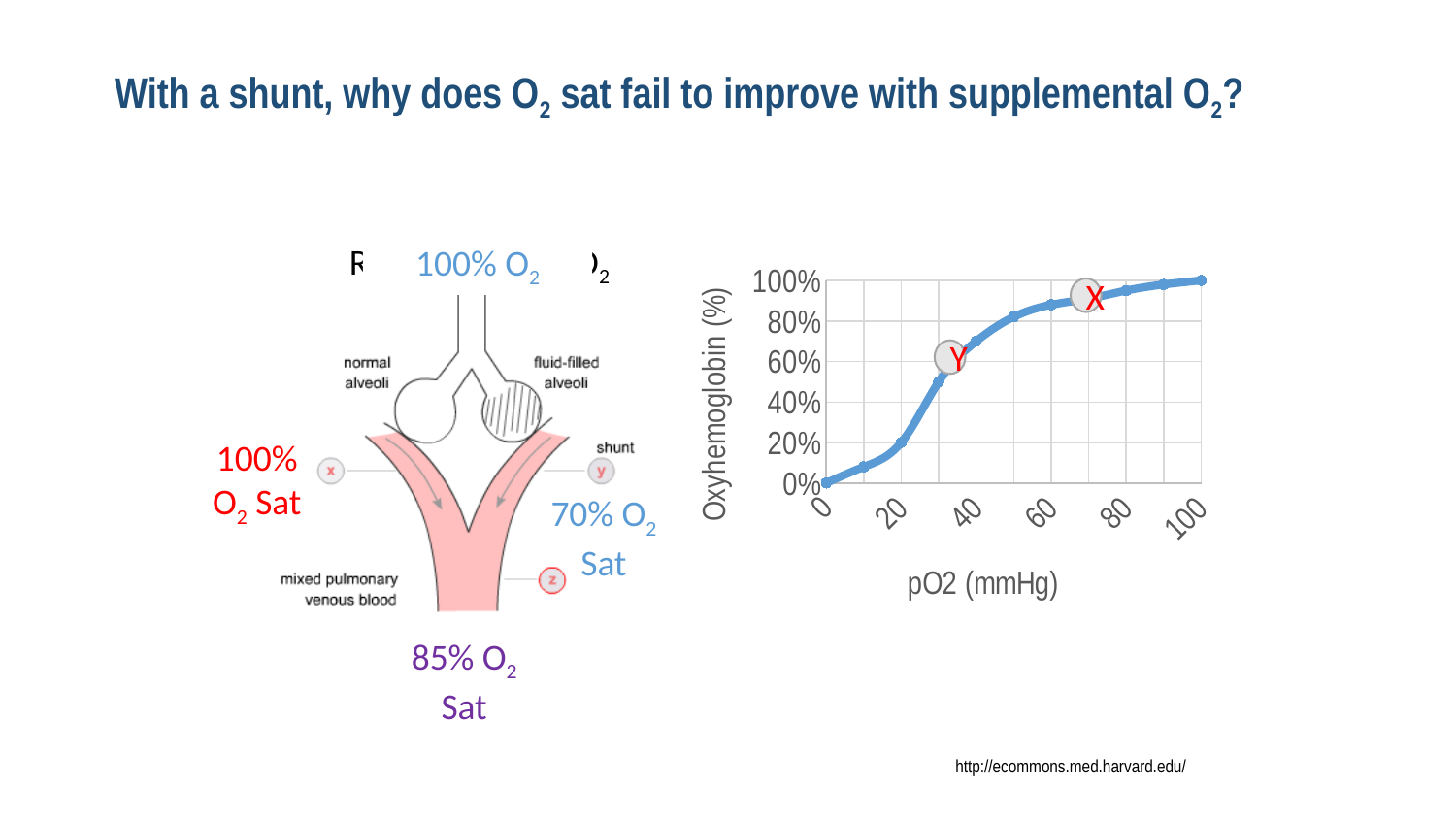
Is the oxyhemoglobin value at pO2 = 60 greater or less than 80%? greater Is the oxyhemoglobin value at the point marked Y greater or less than 80%? less How many lines are plotted on the chart? 1 What is the title of the x axis of the chart? pO2 (mmHg) At which pO2 value on the x axis is the oxyhemoglobin value highest? 100 At which pO2 value on the x axis is the oxyhemoglobin value lowest? 0 Is the oxyhemoglobin value at the point marked X greater or less than 80%? greater Does the oxyhemoglobin value rise or fall as pO2 increases along the x axis? rise What kind of chart is shown on the right side of the slide? line chart Which marked point on the curve has the higher oxyhemoglobin value, X or Y? X What is the title of the y axis of the chart? Oxyhemoglobin (%)